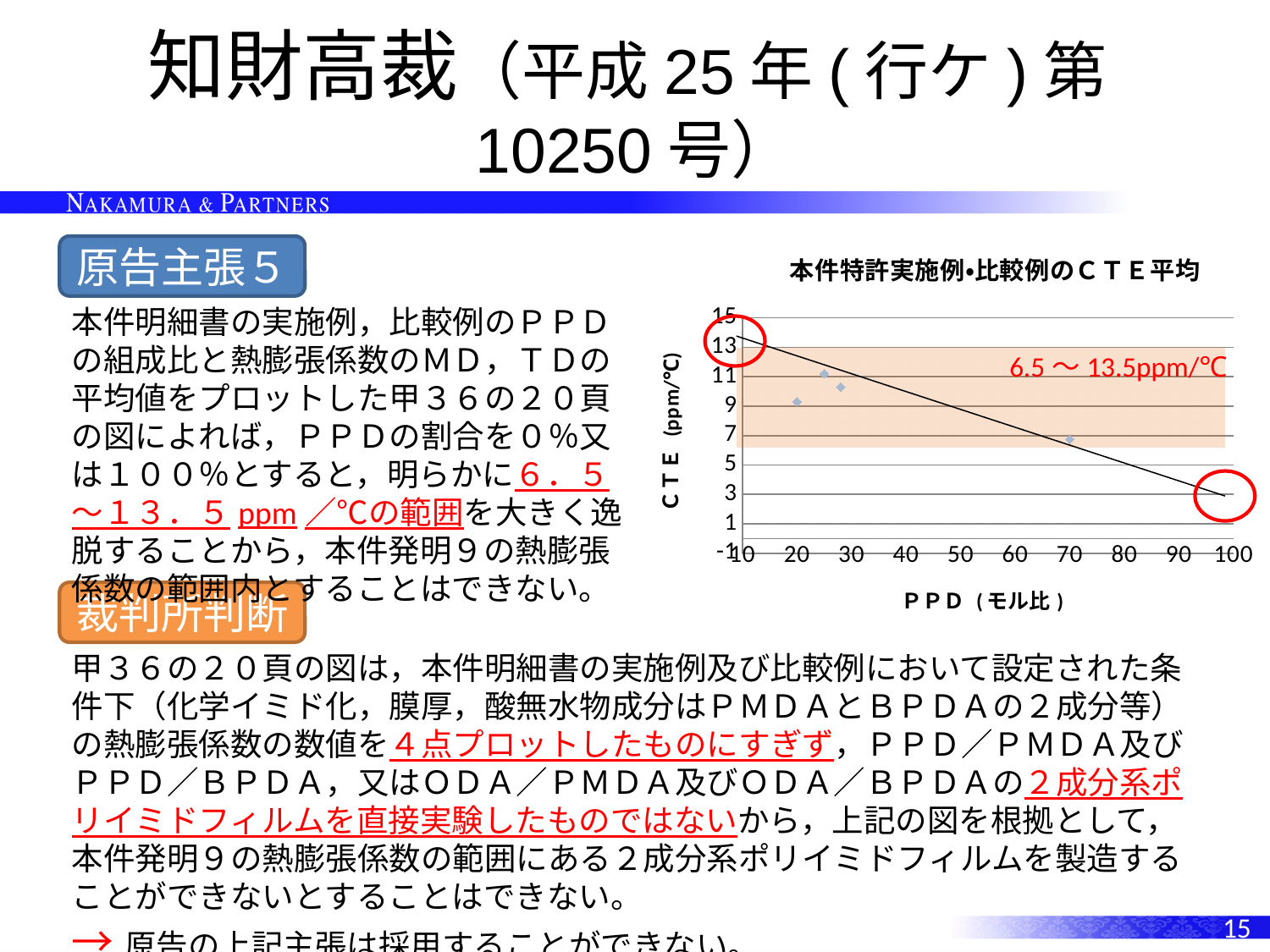
As PPD (モル比) increases along the x axis, does the trend line for CTE rise or fall? fall Is the trend line's CTE value at PPD 100 greater or less than 5? less Which plotted point has the lowest CTE value? the point near PPD 70 What kind of chart is shown on the slide? scatter chart (with a trend line) What is the title of the chart? 本件特許実施例•比較例のＣＴＥ平均 Which has the higher CTE value: the plotted point near PPD 20 or the plotted point near PPD 70? the point near PPD 20 What CTE range is labelled on the shaded band in the chart? 6.5 ～ 13.5ppm/℃ Is the trend line's CTE value at PPD 10 greater or less than 11? greater How many data points are plotted in the chart? 4 Is the CTE value of the plotted point near PPD 70 greater or less than 9? less